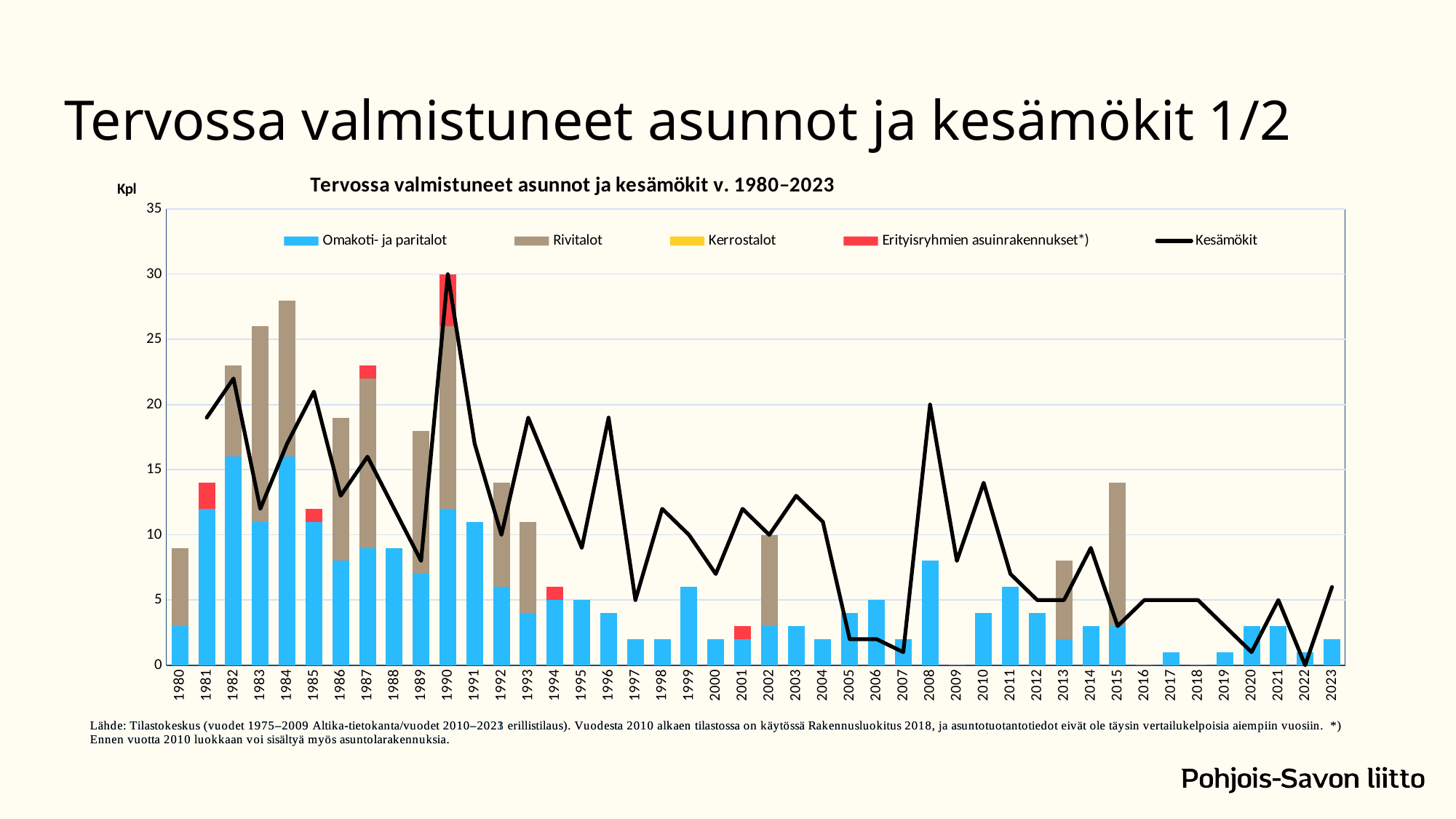
Is the Kesämökit value for 2008 greater or less than 15? greater In which year does the Kesämökit line reach its lowest point? 2022 How many years are shown on the x axis? 44 Is the total stacked bar for 1984 greater or less than 25? greater In which year does the Kesämökit line reach its highest point? 1990 Is the total stacked bar for 2015 greater or less than 10? greater How many series does the legend list? 5 Which series is drawn as a black line? Kesämökit What is the title of the chart? Tervossa valmistuneet asunnot ja kesämökit v. 1980–2023 What kind of chart is shown on the slide? Stacked bar chart with a line Which year has the tallest stacked bar? 1990